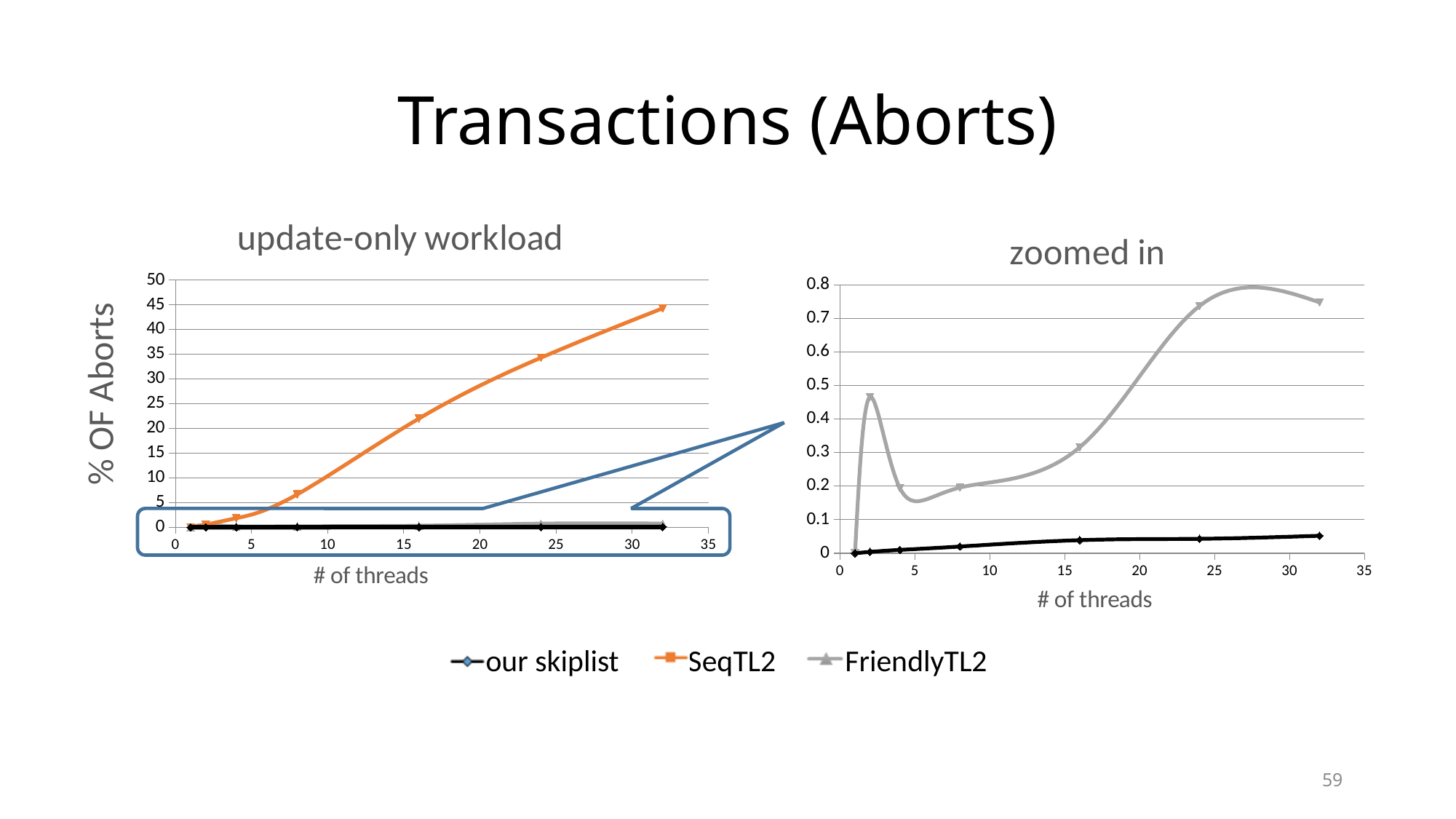
In the 'update-only workload' chart, is the value for SeqTL2 at 32 threads greater or less than 40? greater What is the y-axis label of the 'update-only workload' chart? % OF Aborts In the 'zoomed in' chart, is the value for our skiplist at 32 threads greater or less than 0.1? less In the 'update-only workload' chart, does the SeqTL2 line rise or fall as the number of threads increases? rises In the 'zoomed in' chart, is the value for FriendlyTL2 at 24 threads greater or less than 0.6? greater How many series does the legend list? 3 In the 'update-only workload' chart, which series has the highest % of aborts at 32 threads? SeqTL2 What kind of chart is the 'update-only workload' chart? line chart In the 'zoomed in' chart, which is larger at 16 threads: FriendlyTL2 or our skiplist? FriendlyTL2 In the 'zoomed in' chart, how many data points are plotted for the our skiplist series? 7